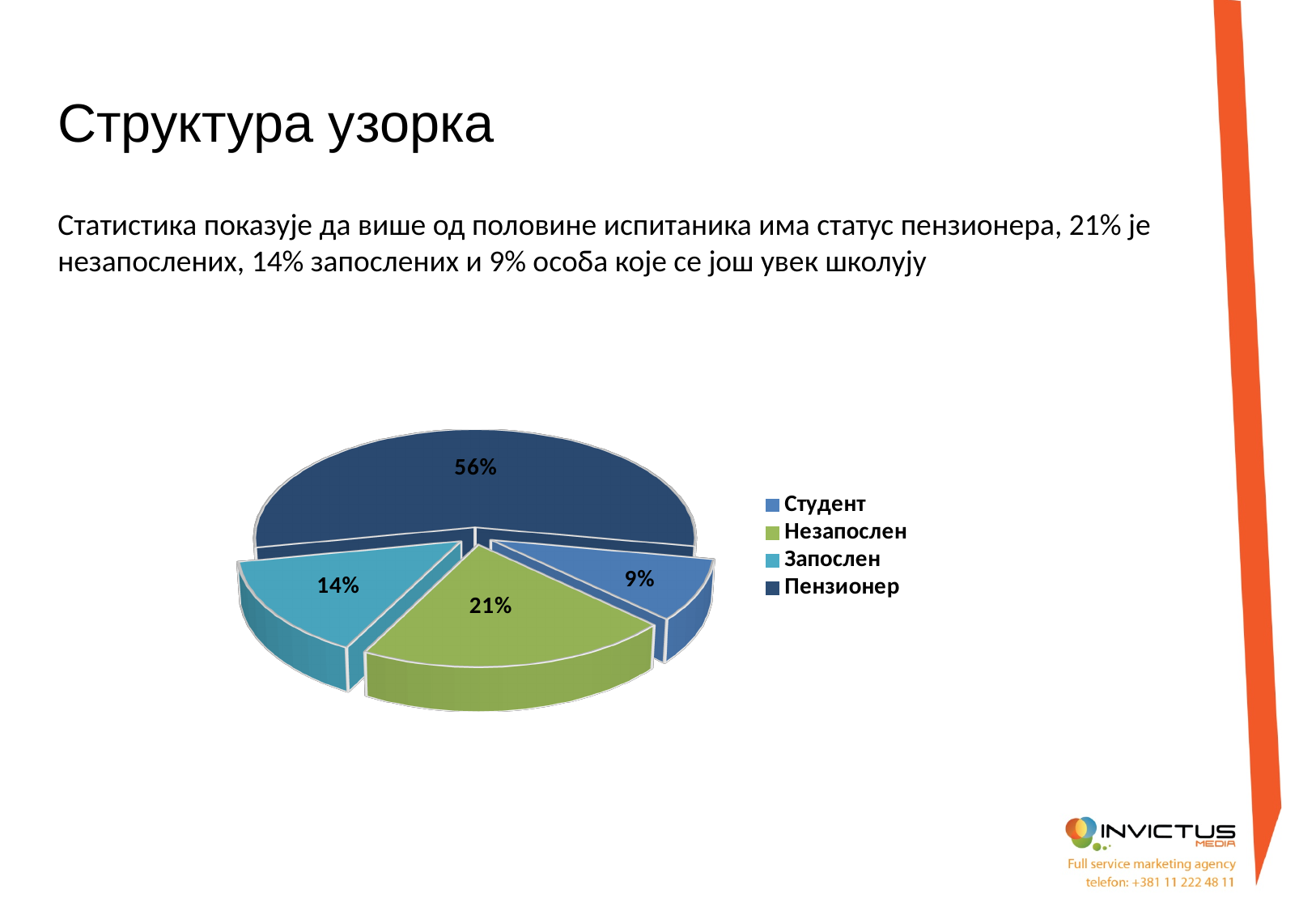
How many categories does the pie chart have? 4 What kind of chart is shown on the slide? Pie chart Which category has the smallest slice of the pie? Студент Which is larger, the share for Незапослен or the share for Запослен? Незапослен Which category has the largest slice of the pie? Пензионер What is the difference between the shares of Пензионер and Незапослен? 35% Which colour represents Пензионер in the pie chart? Dark blue What share of the pie does Пензионер have? 56% What share of the pie does Студент have? 9% What share of the pie does Запослен have? 14% What is the difference between the shares of Запослен and Студент? 5%